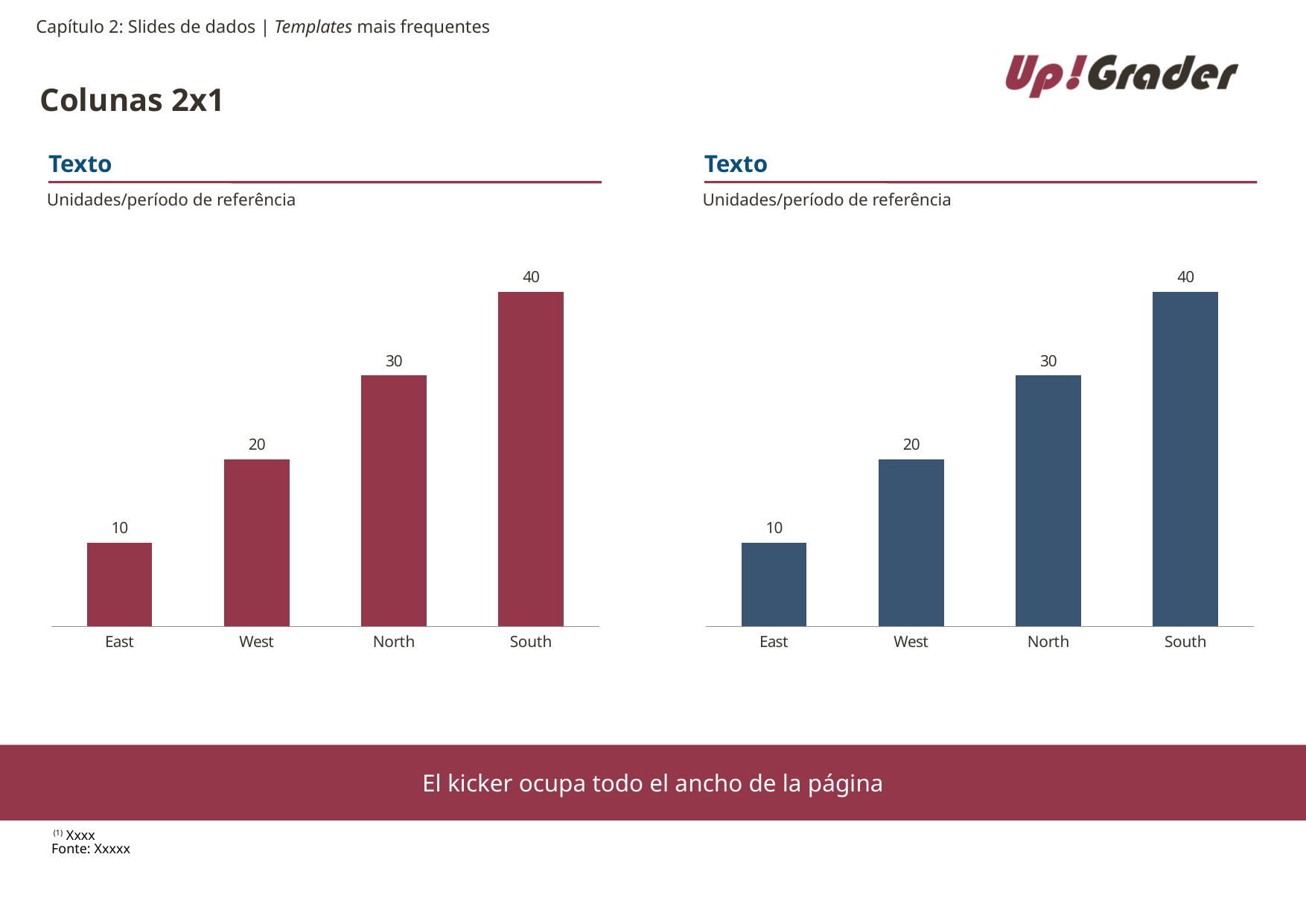
In the right chart, do the values rise or fall from East to South? Rise How many categories are shown in the right chart? 4 What kind of chart is the left chart? Bar chart In the left chart, which category has the highest value? South In the left chart, what is the value for North? 30 What colour are the bars in the right chart? Blue In the left chart, what is the difference between the values for South and East? 30 In the right chart, what is the value for West? 20 In the right chart, what is the difference between the values for North and West? 10 What is the subtitle text shown above each chart? Unidades/período de referência In the right chart, which category has the lowest value? East In the left chart, which is larger, the value for West or the value for North? North